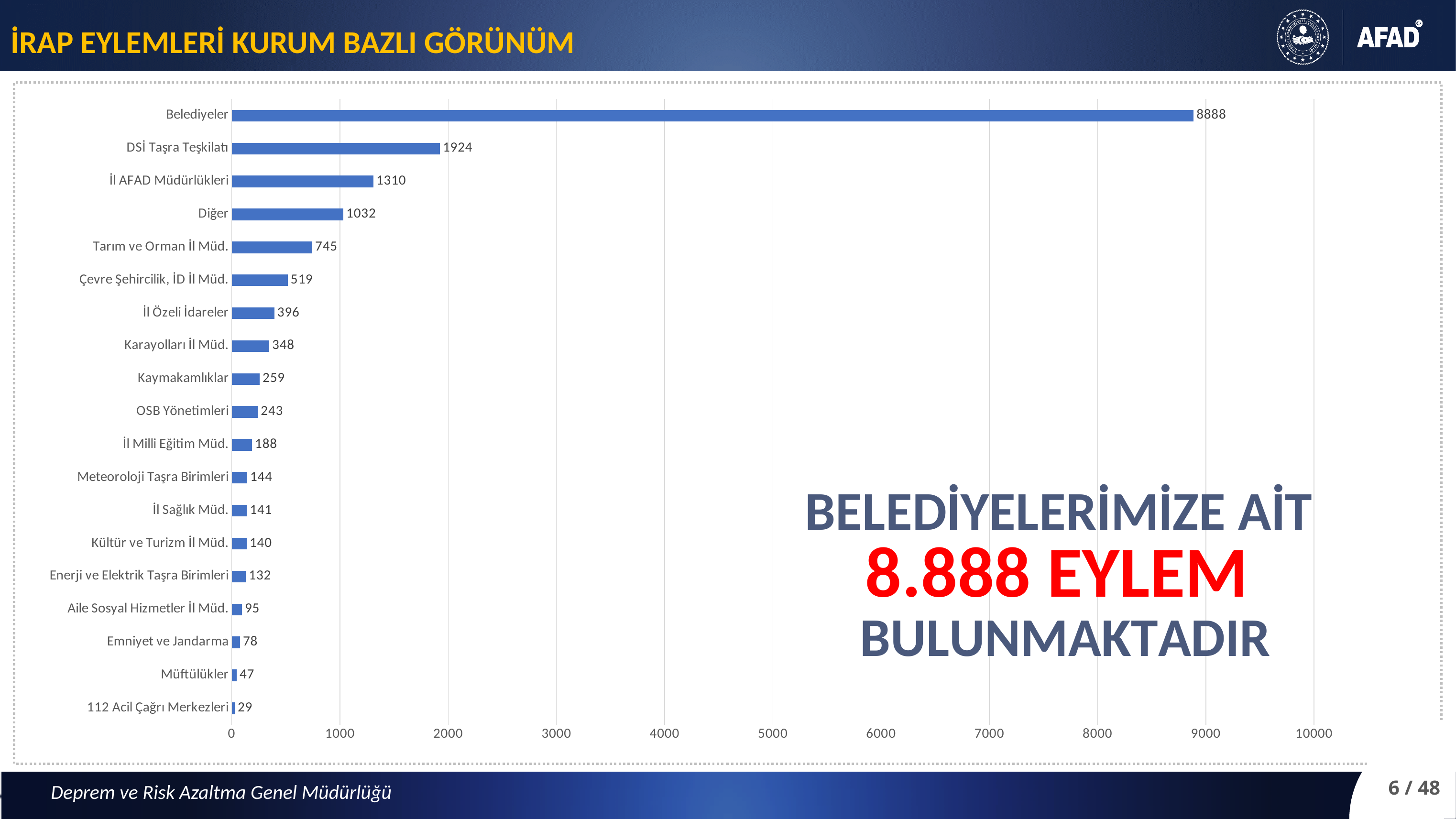
What is the value for Kaymakamlıklar? 259 Is the value for DSİ Taşra Teşkilatı greater or less than 2000? less Which is larger, the value for Tarım ve Orman İl Müd. or the value for Çevre Şehircilik, İD İl Müd.? Tarım ve Orman İl Müd. What is the value for Belediyeler? 8888 What is the title of the slide? İRAP EYLEMLERİ KURUM BAZLI GÖRÜNÜM What is the value for Müftülükler? 47 What is the difference between the values for İl AFAD Müdürlükleri and Diğer? 278 Which category has the highest value? Belediyeler How many categories are shown in the chart? 19 What is the value for DSİ Taşra Teşkilatı? 1924 Which category has the lowest value? 112 Acil Çağrı Merkezleri What kind of chart is shown on the slide? bar chart